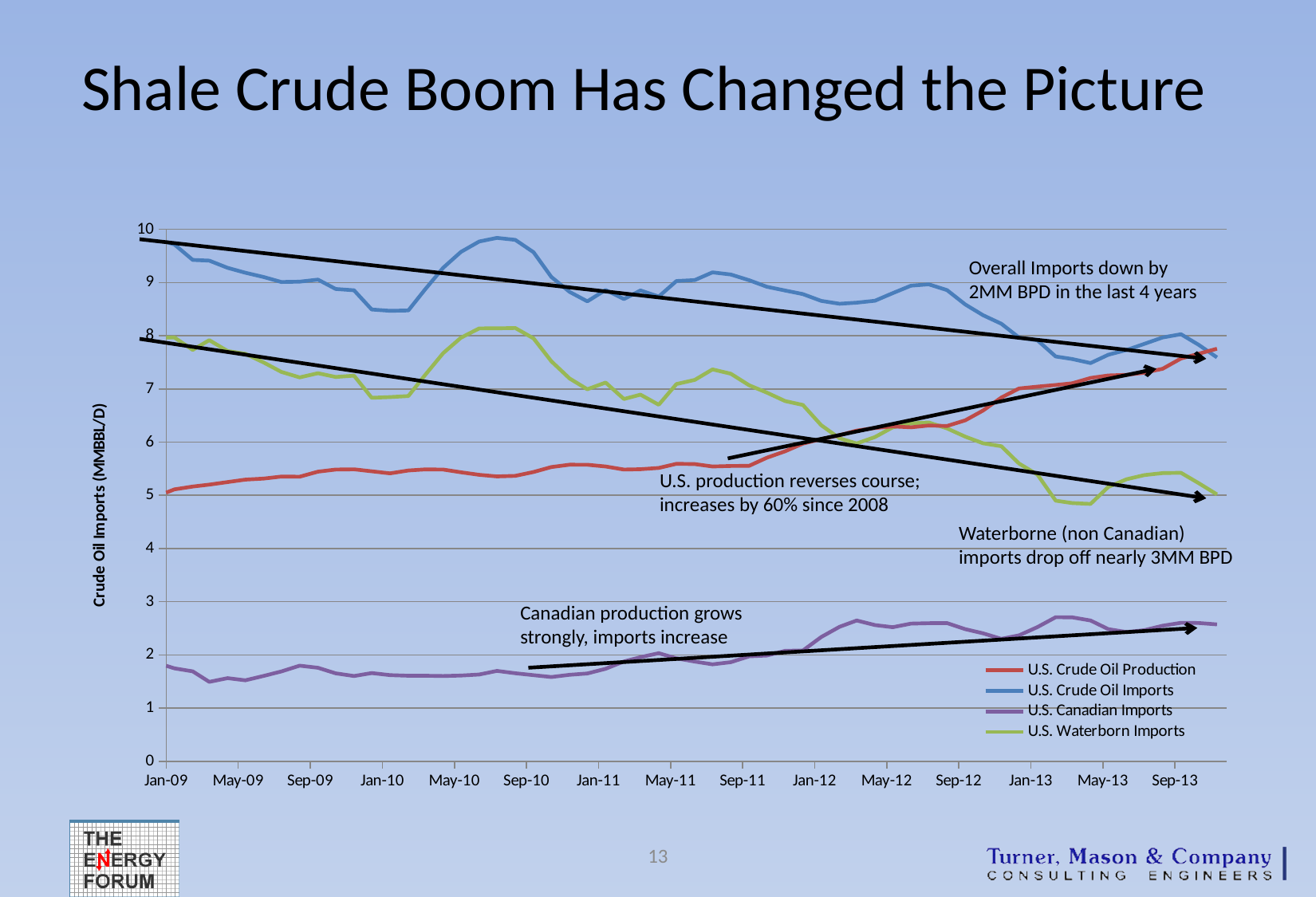
Is the value for U.S. Crude Oil Production at Sep-13 greater or less than 7? greater Is the value for U.S. Canadian Imports at Jan-09 greater or less than 2? less Does the U.S. Waterborn Imports line generally rise or fall across the chart? fall What kind of chart is shown on the slide? line chart Which series is drawn in green in the chart? U.S. Waterborn Imports How many series does the chart legend list? 4 Does the U.S. Crude Oil Imports line generally rise or fall from Jan-09 to Sep-13? fall What is the label on the vertical axis of the chart? Crude Oil Imports (MMBBL/D) Is the value for U.S. Crude Oil Imports at Jan-09 greater or less than 9? greater Which series has the lowest values throughout the chart? U.S. Canadian Imports Does the U.S. Crude Oil Production line generally rise or fall from Jan-09 to Sep-13? rise At Jan-09, which is larger: U.S. Crude Oil Imports or U.S. Crude Oil Production? U.S. Crude Oil Imports